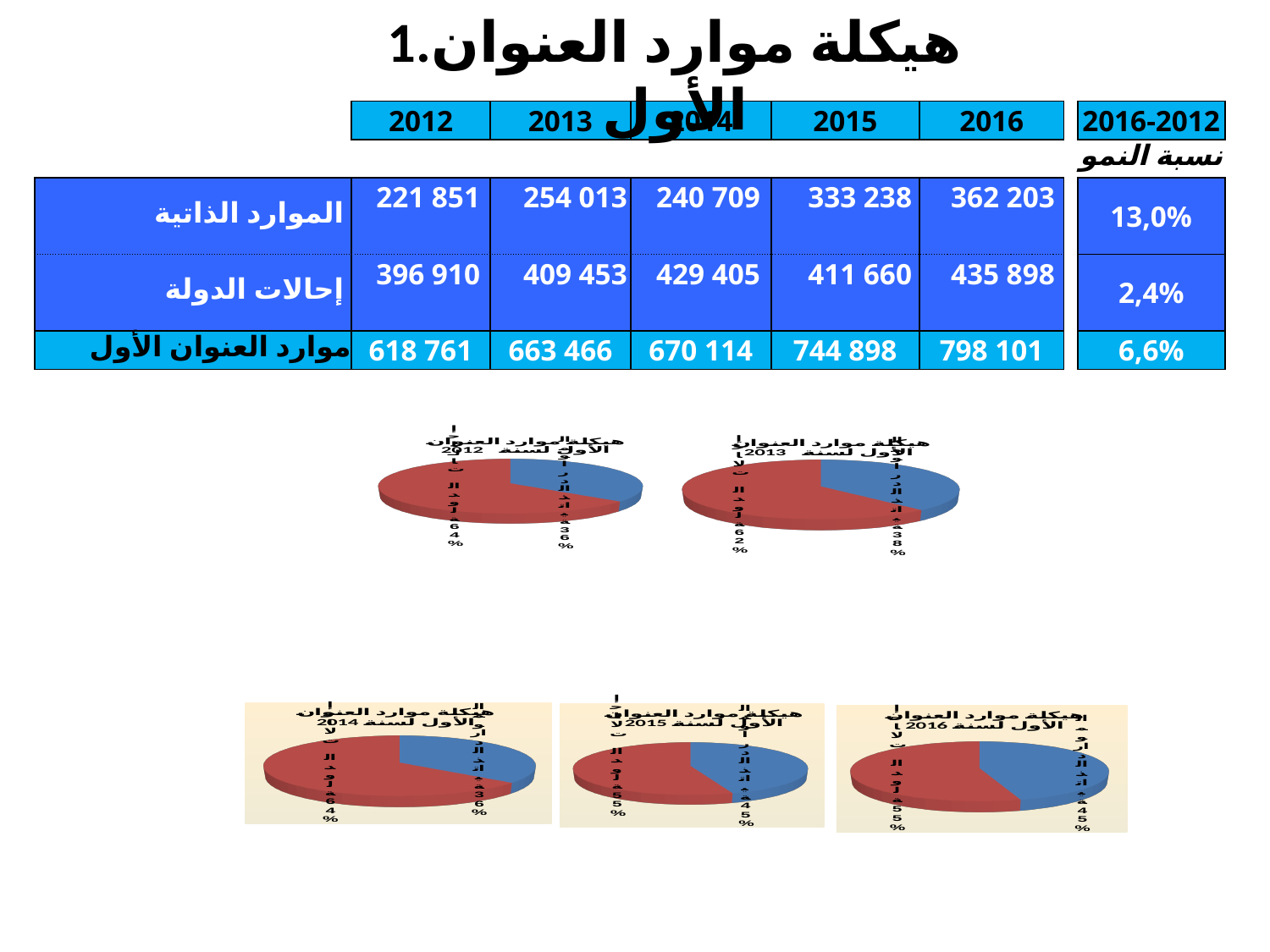
In the 2016 pie chart (هيكلة موارد العنوان الأول لسنة 2016), which slice is larger, the red one or the blue one? the red one In the 2016 pie chart (هيكلة موارد العنوان الأول لسنة 2016), what share does the red slice represent? 55% In the 2015 pie chart (هيكلة موارد العنوان الأول لسنة 2015), what share does the blue slice represent? 45% What kind of chart is used for the 2012 chart (هيكلة موارد العنوان الأول لسنة 2012)? pie chart In the 2012 pie chart (هيكلة موارد العنوان الأول لسنة 2012), how many slices does the pie have? 2 How many pie charts are shown on the slide? 5 In the 2013 pie chart (هيكلة موارد العنوان الأول لسنة 2013), what is the difference in percentage points between the red slice and the blue slice? 24 In the 2014 pie chart (هيكلة موارد العنوان الأول لسنة 2014), what share does the red slice represent? 64%